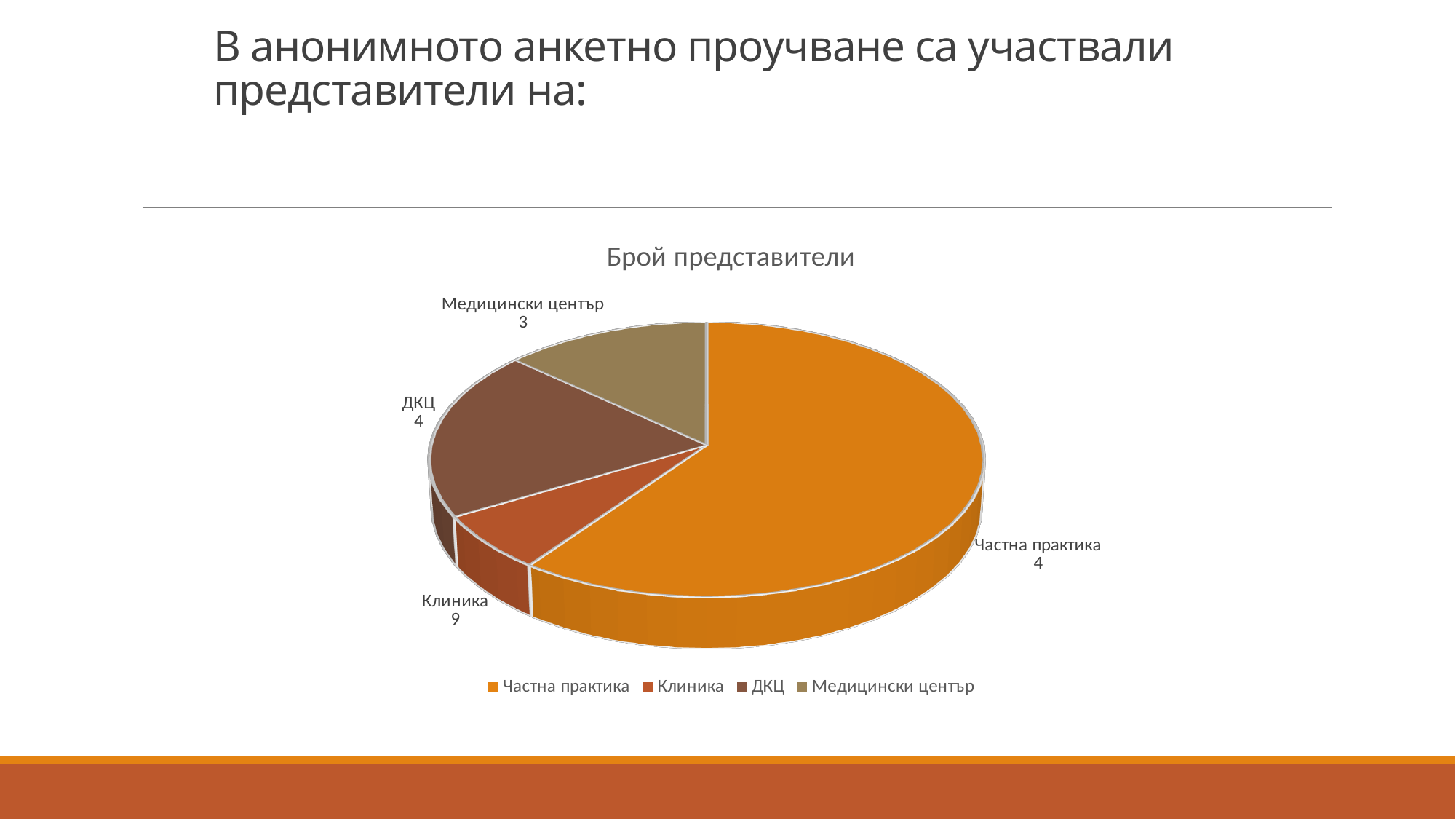
What kind of chart is shown on the slide? pie chart What is the total of all the labelled values in the pie chart? 20 Which has the larger labelled value, ДКЦ or Медицински център? ДКЦ What value is labelled for Медицински център? 3 What is the difference between the labelled values for Клиника and Медицински център? 6 Which legend entry is listed first? Частна практика What value is labelled for ДКЦ? 4 What value is labelled for Клиника? 9 What is the title of the chart? Брой представители What value is labelled for Частна практика? 4 How many entries does the legend list? 4 How many categories does the pie chart show? 4